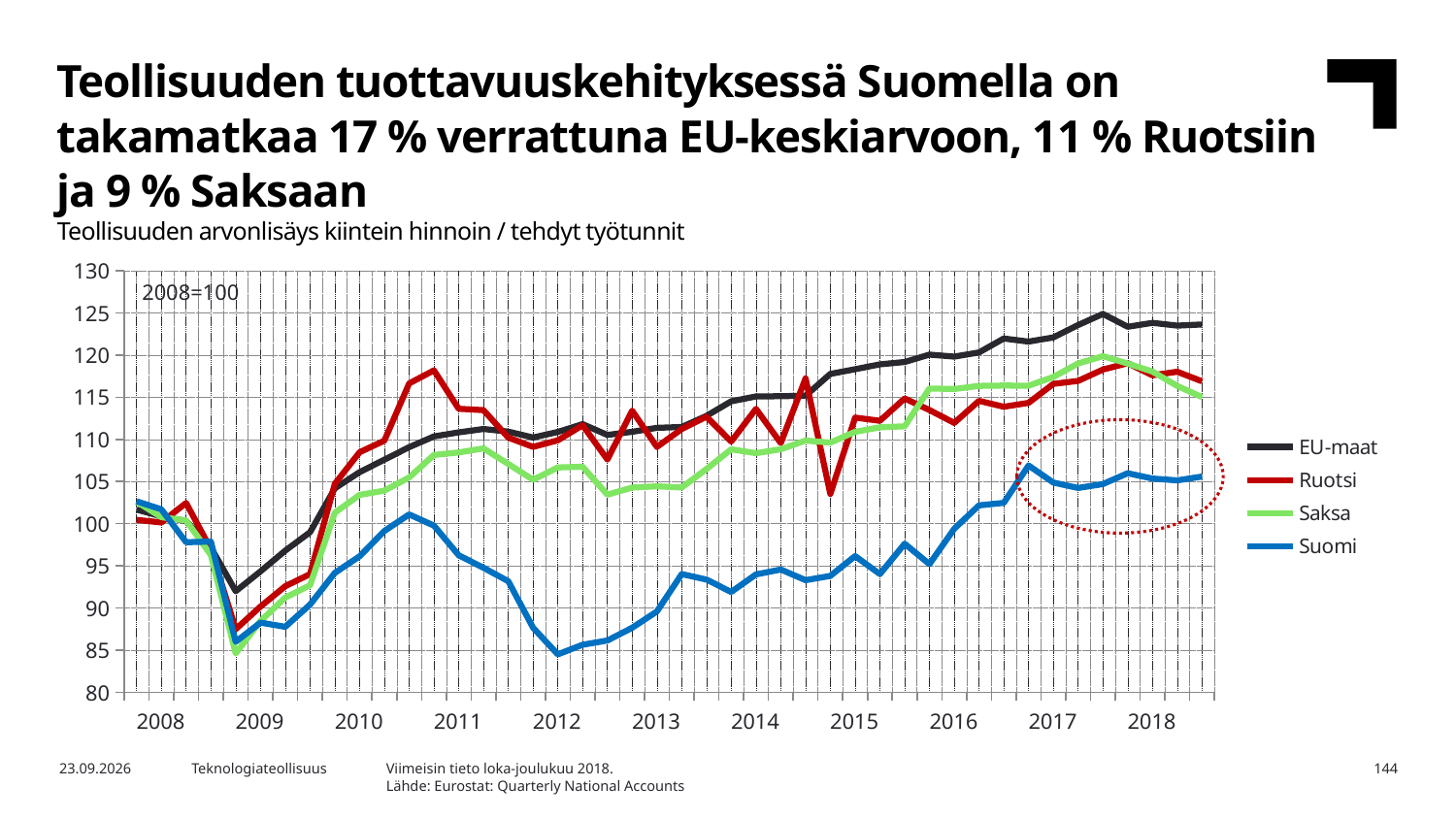
How many series does the legend list? 4 Is the value for Suomi at the end of 2018 greater or less than 100? greater How many years are labelled on the x axis? 11 Does the Suomi line rise or fall overall from 2012 to 2018? rise At the end of 2018, which is higher, EU-maat or Suomi? EU-maat What kind of chart is shown on the slide? line chart Which series is the lowest at the end of 2018? Suomi Which series is the highest at the end of 2018? EU-maat Is the lowest value for Suomi, reached around 2012, greater or less than 90? less Which series is highlighted with a dotted red circle on the chart? Suomi Is the value for EU-maat at the end of 2018 greater or less than 120? greater